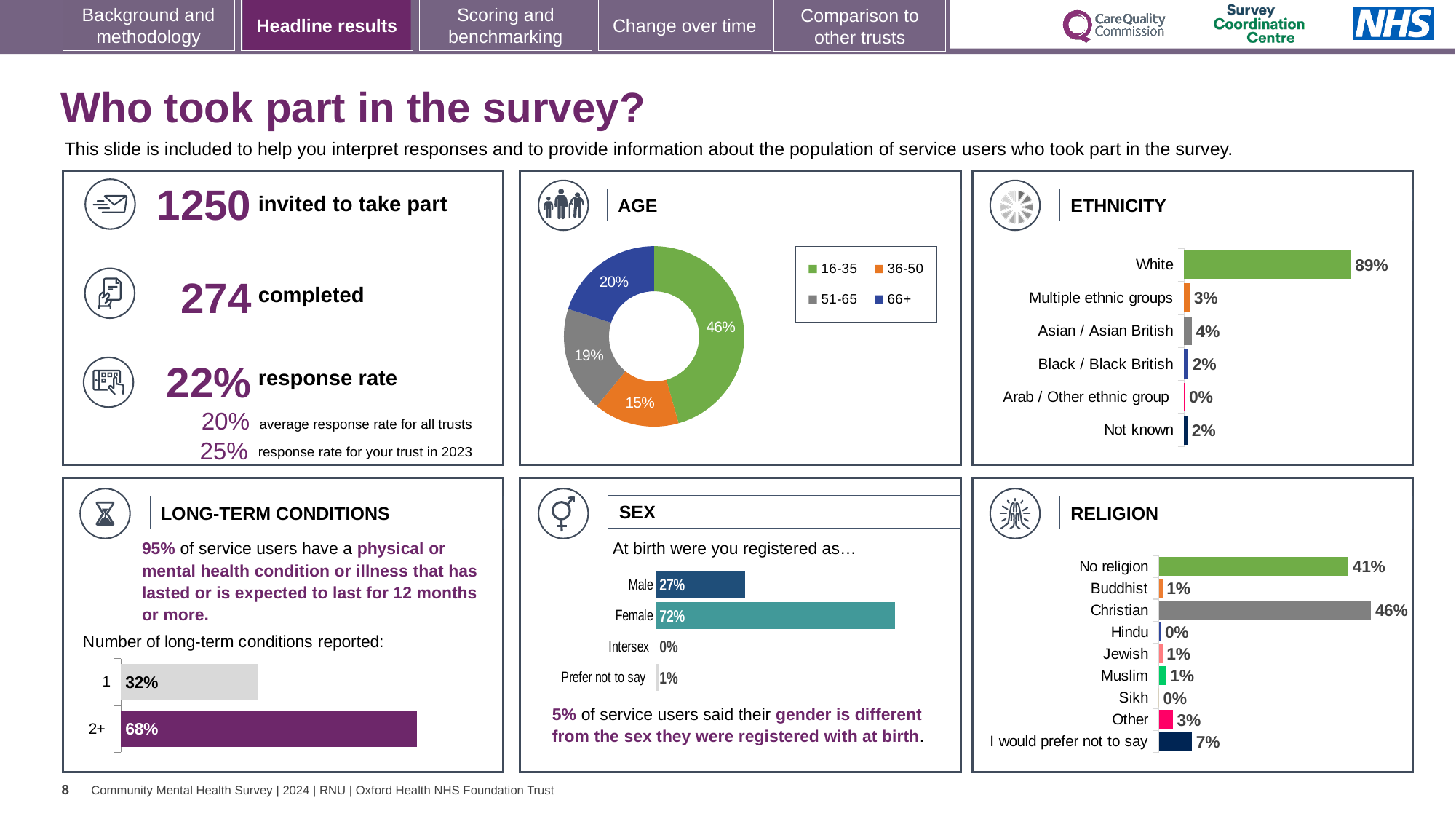
In the ETHNICITY chart, what is the value for Asian / Asian British? 4% How many series does the legend of the AGE chart list? 4 In the ETHNICITY chart, what is the difference between White and Multiple ethnic groups? 86% In the AGE chart, which age group has the smallest share? 36-50 In the AGE chart, what share of respondents were aged 16-35? 46% In the RELIGION chart, which category has the highest value? Christian What kind of chart is the AGE chart? Doughnut chart How many categories are shown in the ETHNICITY chart? 6 In the ETHNICITY chart, which category has the highest value? White In the LONG-TERM CONDITIONS chart, what is the difference between the 2+ and 1 bars? 36% In the RELIGION chart, what is the value for I would prefer not to say? 7% In the SEX chart, which is larger, Male or Female? Female